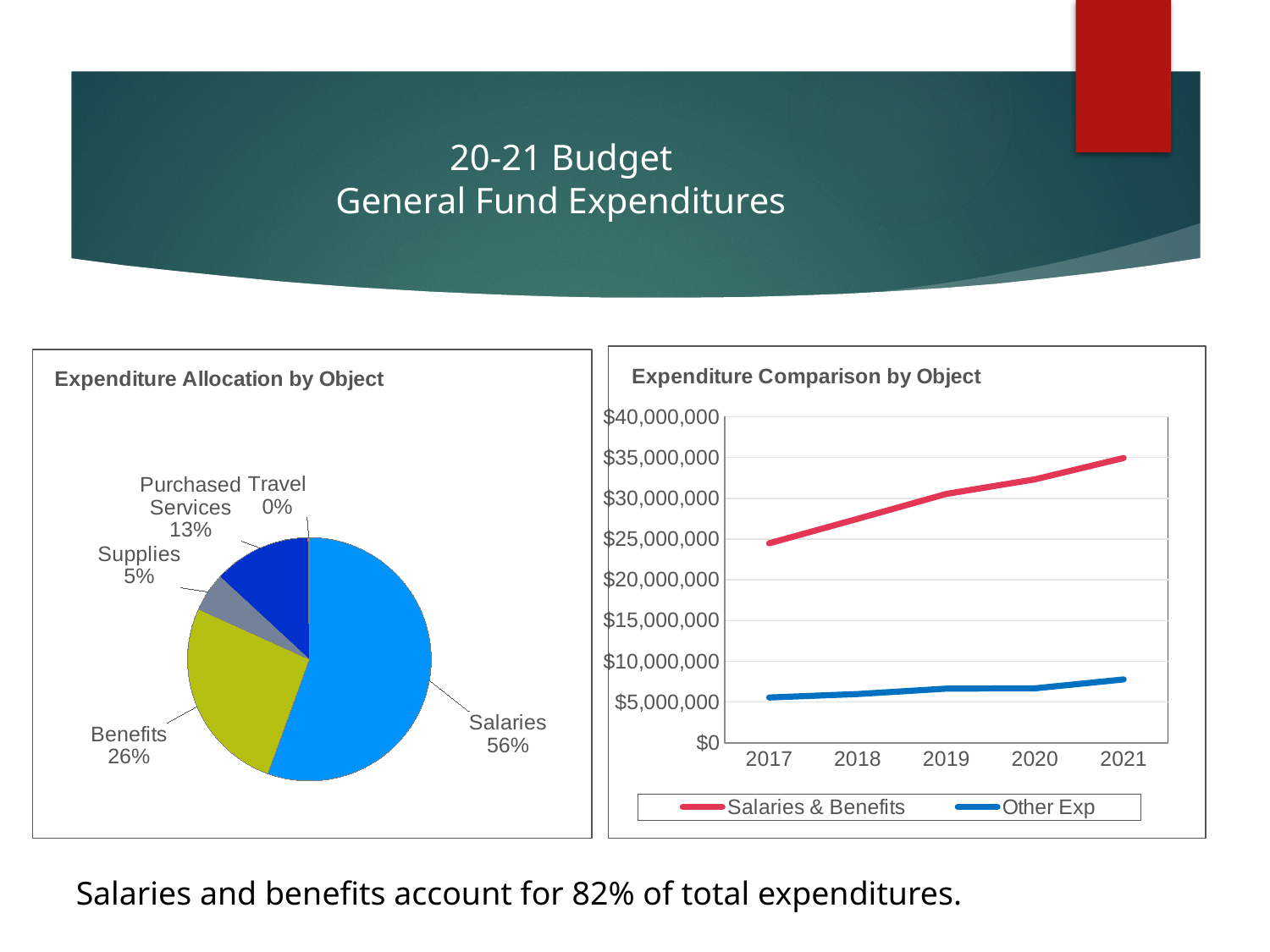
What kind of chart is 'Expenditure Allocation by Object'? Pie chart In the 'Expenditure Allocation by Object' chart, what share of expenditures is Salaries? 56% In the 'Expenditure Allocation by Object' chart, what share of expenditures is Purchased Services? 13% In the 'Expenditure Allocation by Object' chart, how many categories are shown? 5 In the 'Expenditure Allocation by Object' chart, which category has the smallest slice? Travel In the 'Expenditure Comparison by Object' chart, is the value for Salaries & Benefits in 2021 greater or less than $30,000,000? greater In the 'Expenditure Comparison by Object' chart, does the Salaries & Benefits line rise or fall from 2017 to 2021? Rise In the 'Expenditure Allocation by Object' chart, what share of expenditures is Benefits? 26% In the 'Expenditure Allocation by Object' chart, what is the difference in percentage points between Salaries and Benefits? 30 In the 'Expenditure Comparison by Object' chart, how many series does the legend list? 2 In the 'Expenditure Allocation by Object' chart, which category has the largest slice? Salaries What kind of chart is 'Expenditure Comparison by Object'? Line chart